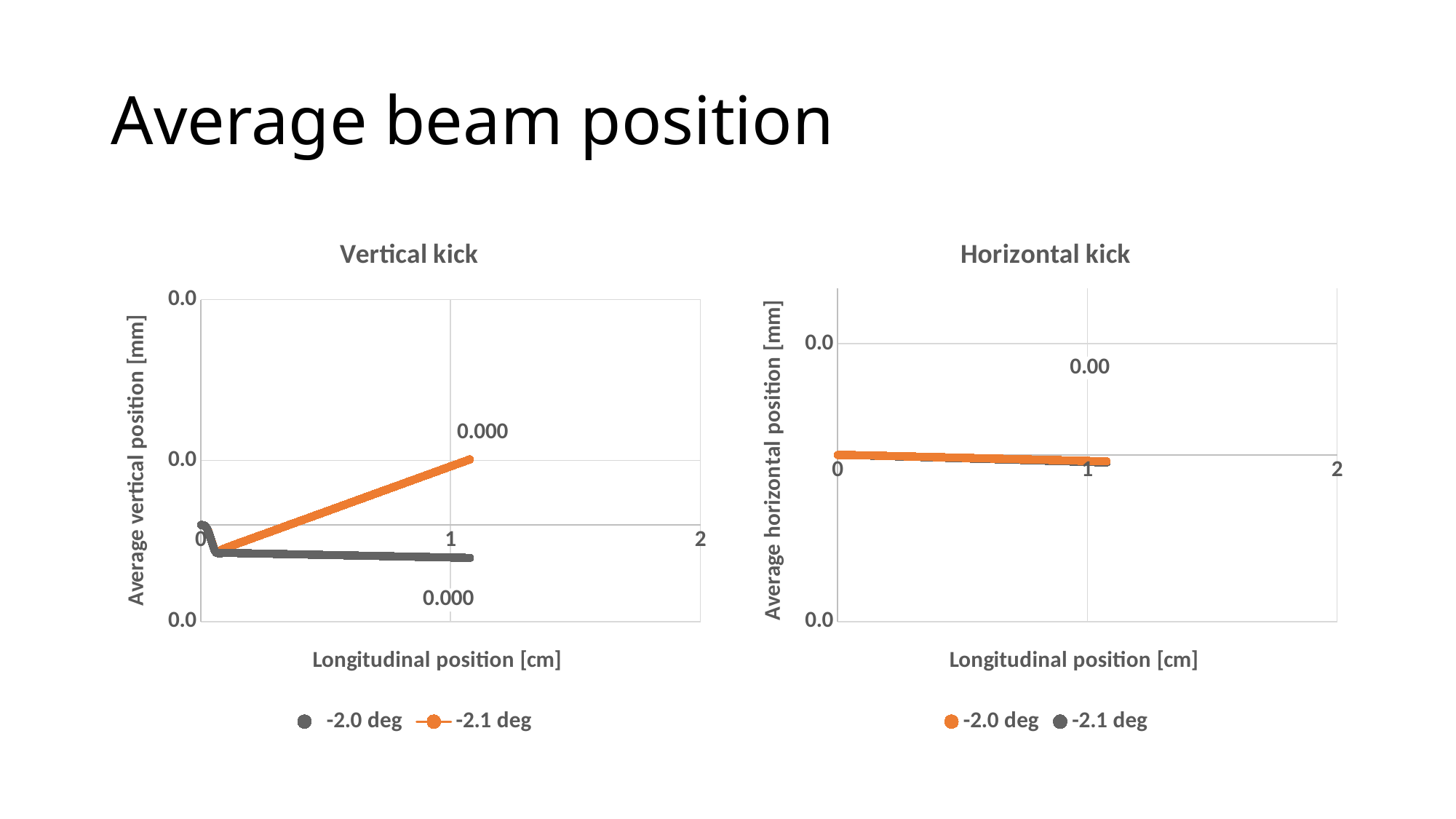
In the Horizontal kick chart, which series is drawn in orange? -2.0 deg How many series does the legend of the Vertical kick chart list? 2 What is the x-axis label of the Horizontal kick chart? Longitudinal position [cm] In the Vertical kick chart, does the -2.1 deg series rise or fall as longitudinal position increases from 0 to 1 cm? rise What is the y-axis label of the Vertical kick chart? Average vertical position [mm] In the Vertical kick chart, which series is higher at a longitudinal position of 1 cm, -2.0 deg or -2.1 deg? -2.1 deg How many series does the legend of the Horizontal kick chart list? 2 What kind of chart is the Vertical kick chart? line chart In the Vertical kick chart, which series has the lower average vertical position at a longitudinal position of 1 cm? -2.0 deg